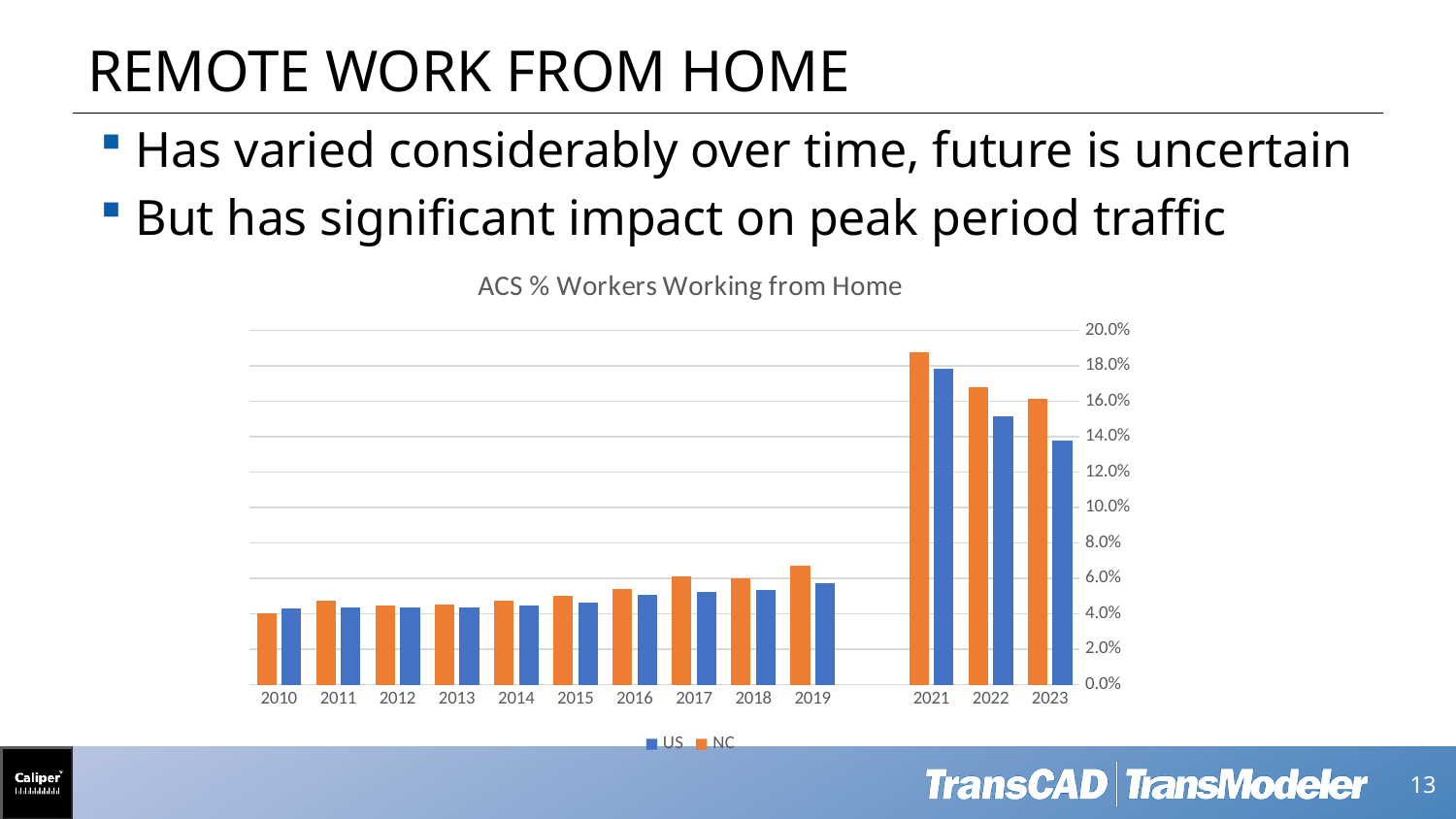
Which year and series has the highest value in the chart? NC in 2021 What kind of chart is shown on the slide? bar chart Is the US value for 2022 greater or less than 16.0%? less What is the title of the chart? ACS % Workers Working from Home How many years are shown on the x axis of the chart? 13 Is the NC value for 2021 greater or less than 18.0%? greater Which colour represents the NC series in the chart? orange How many series does the chart legend list? 2 Which is larger in 2023, the US value or the NC value? NC Is the NC value for 2022 greater or less than 16.0%? greater Do the US values rise or fall from 2021 to 2023? fall